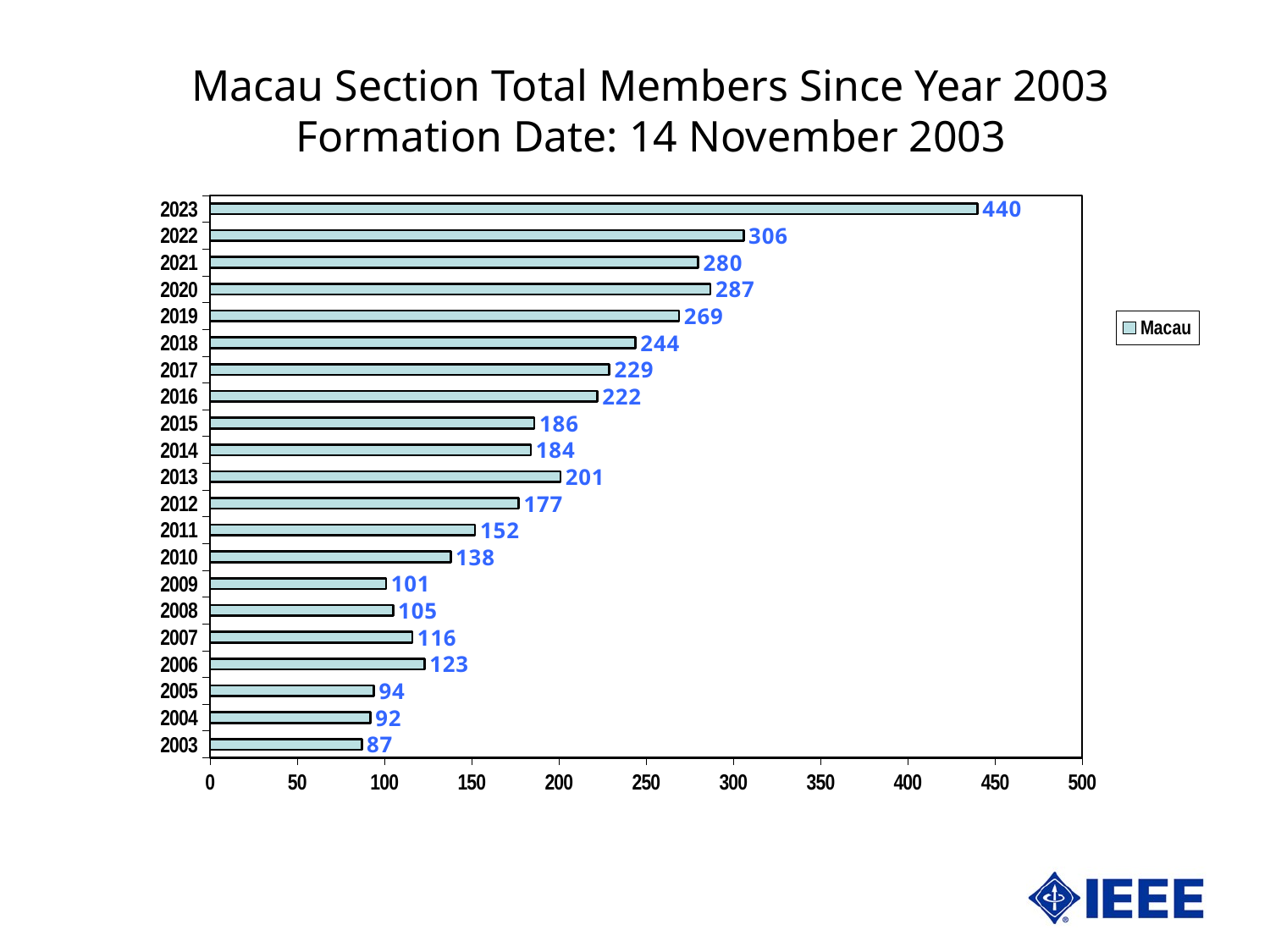
Is the value for 2019 greater or less than 250? greater What kind of chart is this? bar chart What is the value for 2023? 440 What is the value for 2013? 201 What is the difference between the values for 2023 and 2022? 134 Which is larger, the value for 2020 or the value for 2021? 2020 What is the name of the series in the legend? Macau Which year has the lowest value? 2003 How many series does the legend list? 1 Which year has the highest value? 2023 How many years are shown on the chart? 21 What is the value for 2003? 87